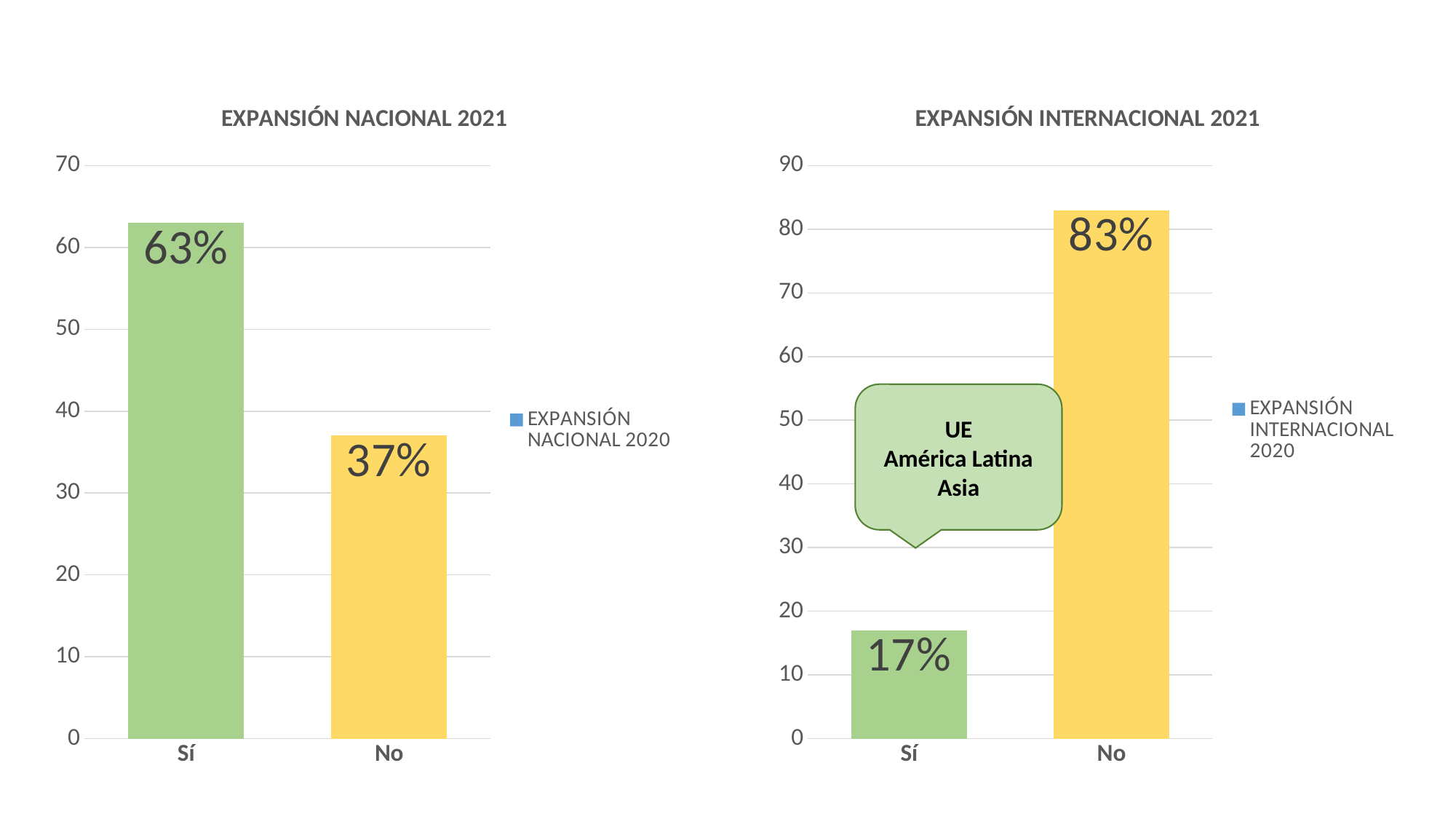
What legend entry is shown next to the EXPANSIÓN INTERNACIONAL 2021 chart? EXPANSIÓN INTERNACIONAL 2020 In the EXPANSIÓN NACIONAL 2021 chart, what is the value for Sí? 63% In the EXPANSIÓN NACIONAL 2021 chart, what is the difference between the values for Sí and No? 26% In the EXPANSIÓN INTERNACIONAL 2021 chart, which category has the lowest value? Sí What kind of chart is the EXPANSIÓN INTERNACIONAL 2021 chart? Bar chart In the EXPANSIÓN NACIONAL 2021 chart, what is the value for No? 37% In the EXPANSIÓN INTERNACIONAL 2021 chart, what is the difference between the values for No and Sí? 66% In the EXPANSIÓN INTERNACIONAL 2021 chart, which is larger, the value for Sí or the value for No? No In the EXPANSIÓN NACIONAL 2021 chart, which category has the highest value? Sí How many categories are shown in the EXPANSIÓN NACIONAL 2021 chart? 2 In the EXPANSIÓN INTERNACIONAL 2021 chart, what is the value for No? 83% In the EXPANSIÓN INTERNACIONAL 2021 chart, what is the value for Sí? 17%